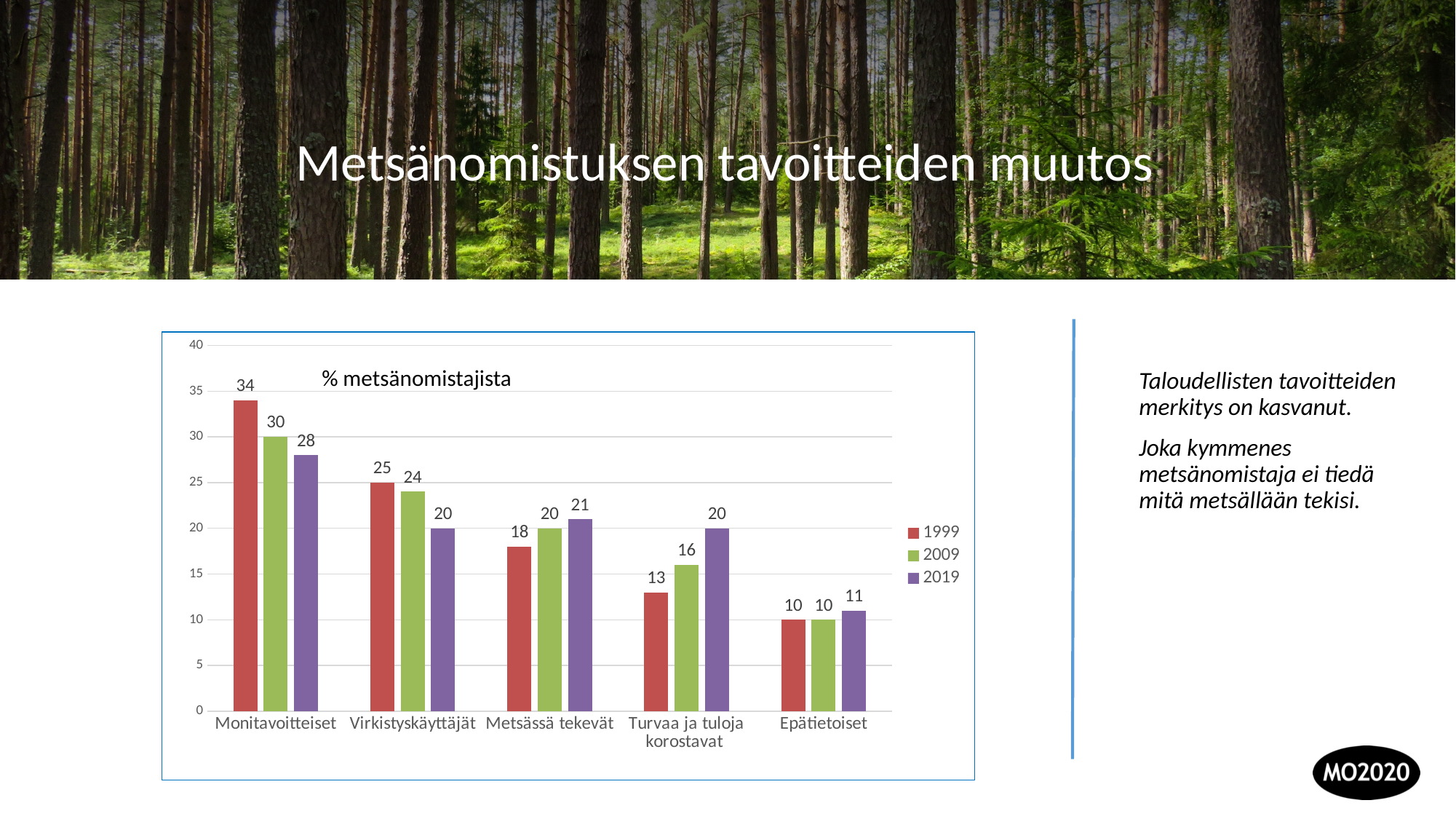
What kind of chart is shown on the slide? bar chart Which category has the highest value in 2019? Monitavoitteiset What is the difference between the 1999 and 2019 values for Monitavoitteiset? 6 Which category has the lowest value in 1999? Epätietoiset What is the value for Turvaa ja tuloja korostavat in 2019? 20 How many categories are shown on the x axis? 5 What is the value for Epätietoiset in 2009? 10 What text label appears inside the chart area above the bars? % metsänomistajista Do the values for Virkistyskäyttäjät rise or fall from 1999 to 2019? fall What is the value for Monitavoitteiset in 1999? 34 How many series does the legend list? 3 Which is larger for Metsässä tekevät: the 1999 value or the 2019 value? 2019